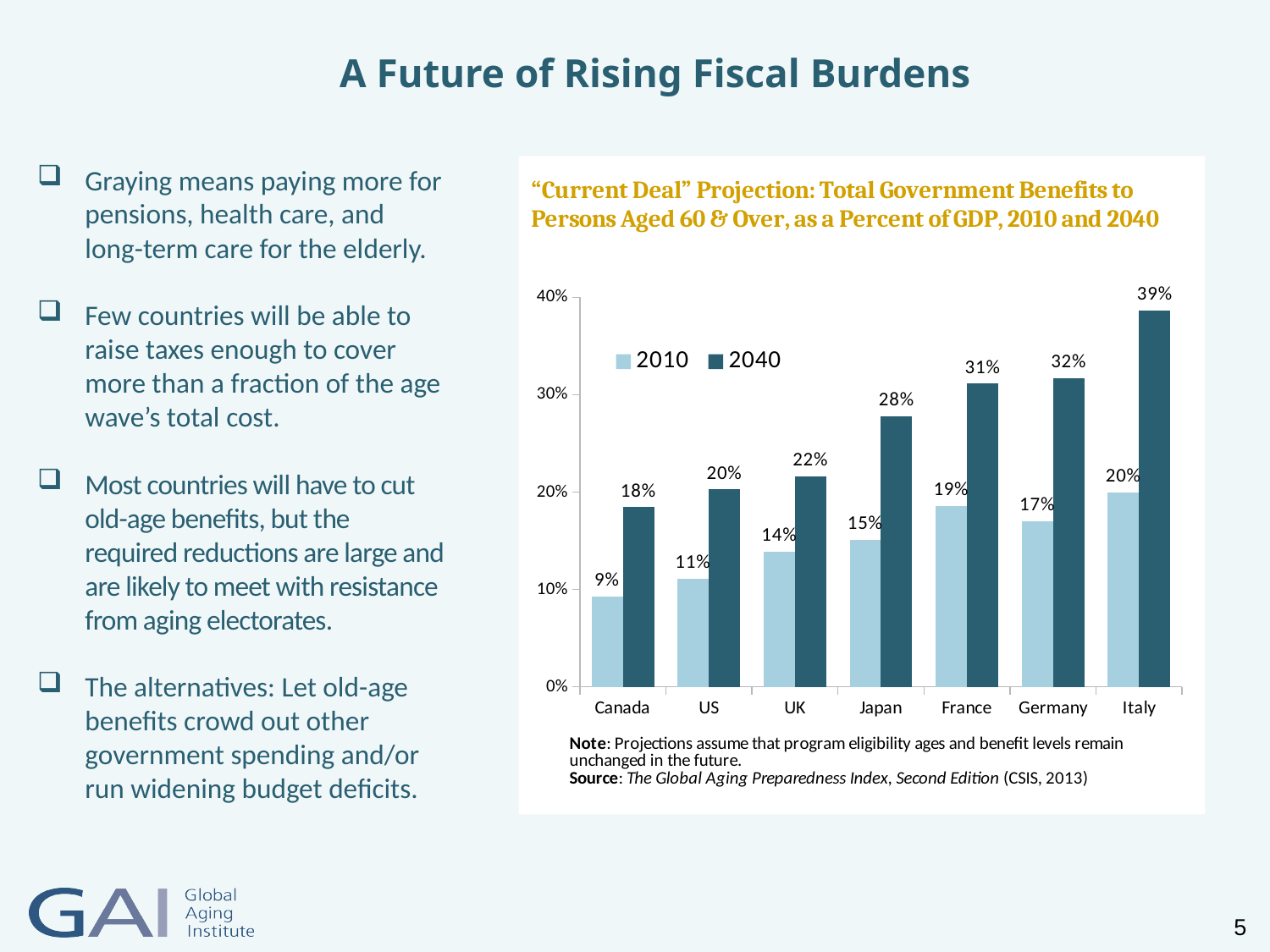
What is the 2010 value for Canada? 9% Which is larger, the 2040 value for France or the 2040 value for Germany? Germany Which country has the highest 2040 value? Italy What is the 2040 value for Japan? 28% Which country has the lowest 2010 value? Canada What is the difference between the 2040 and 2010 values for Germany? 15% What is the 2010 value for France? 19% How many series does the legend list? 2 What is the 2040 value for Italy? 39% What kind of chart is shown? Bar chart Which series is shown in the darker colour? 2040 How many countries are shown on the x axis? 7